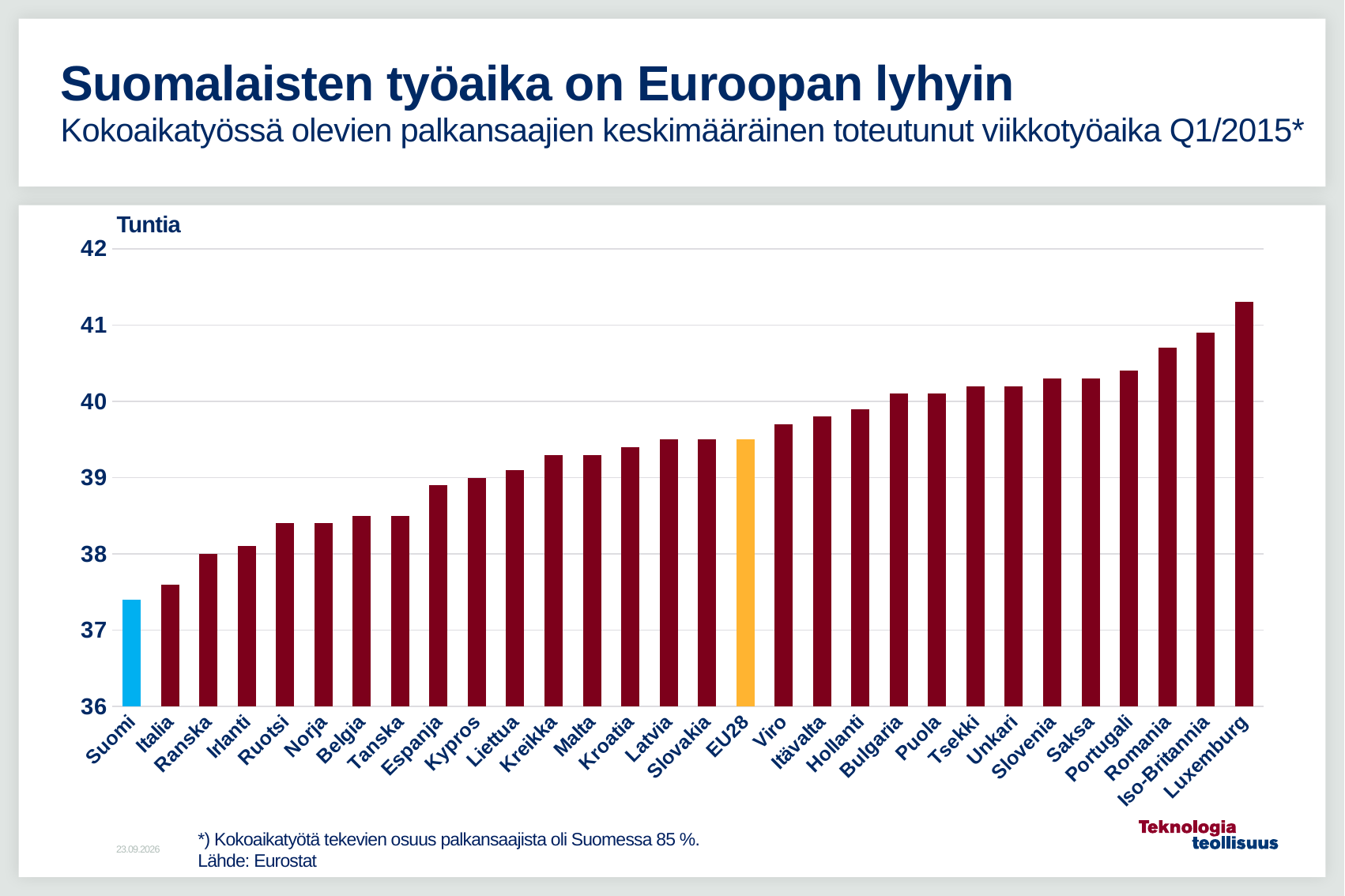
Which country has the highest average weekly working time in the chart? Luxemburg Which country has the lowest average weekly working time in the chart? Suomi Is the value for Suomi greater or less than 38? less What kind of chart is shown on the slide? Bar chart How many bars (categories) are plotted in the chart? 30 Which has a larger value, Romania or Viro? Romania Is the value for Espanja greater or less than 39? less Is the value for Luxemburg greater or less than 41? greater What colour is the bar for Suomi? Blue What unit is shown on the vertical axis label? Tuntia Do the values rise or fall moving from left to right along the x axis? Rise